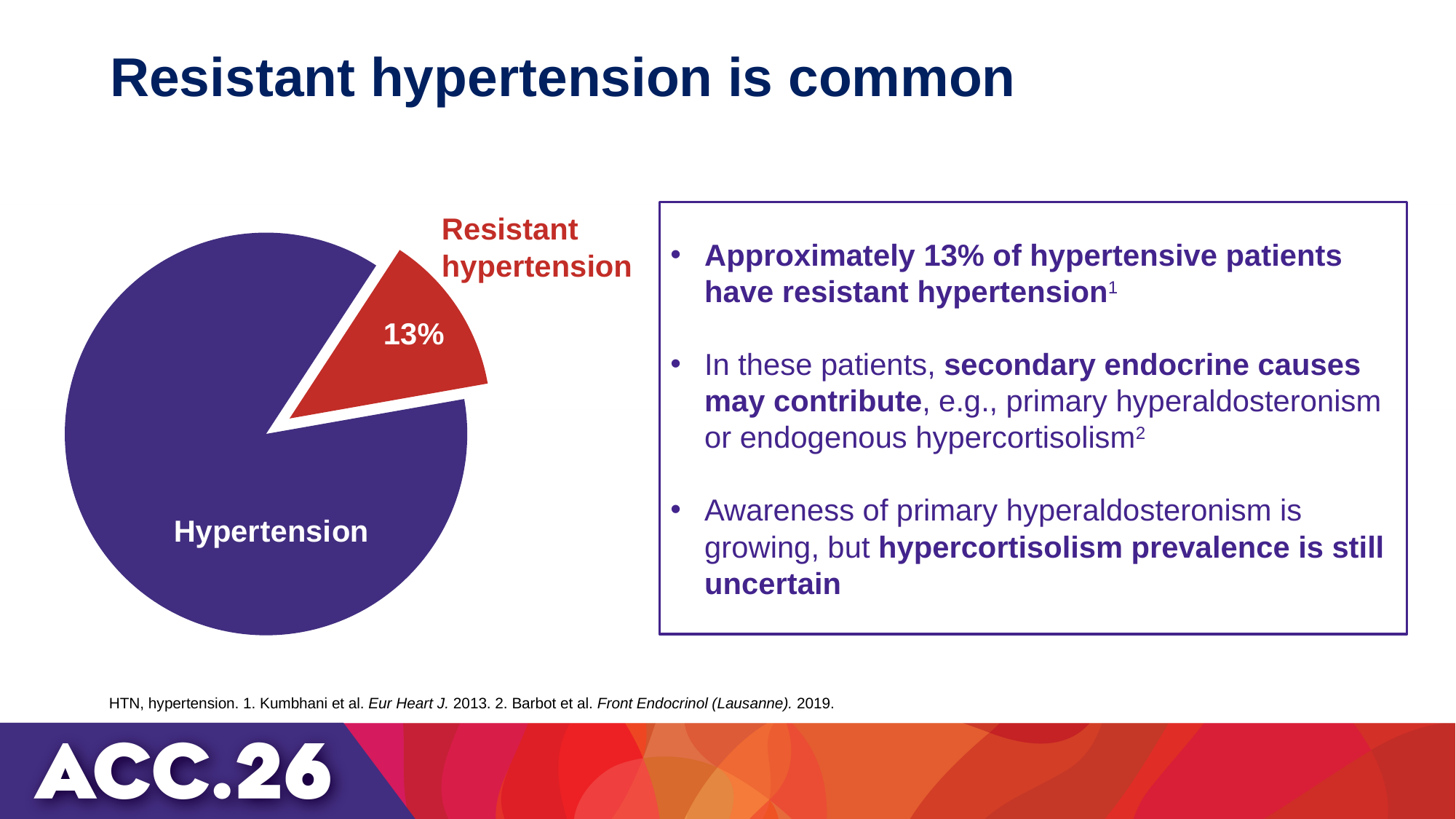
What value is labelled on the Resistant hypertension slice of the pie chart? 13% Which slice of the pie chart is the smallest? Resistant hypertension Is the Resistant hypertension slice greater or less than half of the pie? less Which slice of the pie chart is the largest? Hypertension What kind of chart is shown on the slide? Pie chart Which is larger in the pie chart, the Hypertension slice or the Resistant hypertension slice? Hypertension How many slices does the pie chart have? 2 What share of the pie does the Resistant hypertension slice represent? 13% What colour is the Hypertension slice in the pie chart? Purple What colour is the Resistant hypertension slice in the pie chart? Red